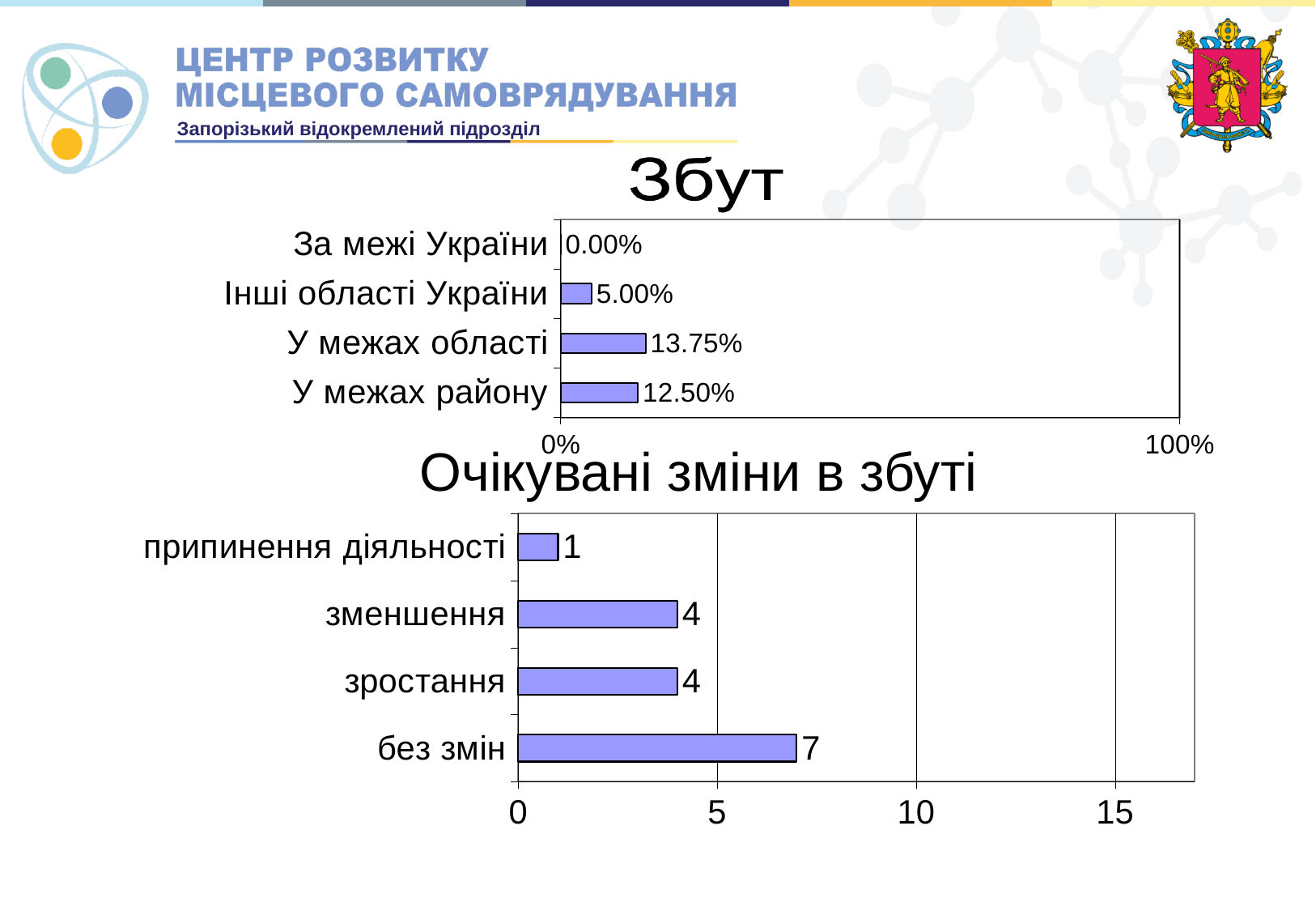
In the chart titled "Очікувані зміни в збуті", what is the difference between the values for "без змін" and "зменшення"? 3 In the chart titled "Очікувані зміни в збуті", what is the value for "припинення діяльності"? 1 In the chart titled "Збут", which category has the lowest value? За межі України In the chart titled "Збут", how many categories are shown? 4 What kind of chart is the chart titled "Очікувані зміни в збуті"? bar chart In the chart titled "Збут", what is the value for "У межах області"? 13.75% In the chart titled "Очікувані зміни в збуті", is the value for "без змін" greater or less than 5? greater In the chart titled "Очікувані зміни в збуті", which category has the highest value? без змін In the chart titled "Збут", what is the difference between the values for "У межах області" and "У межах району"? 1.25% In the chart titled "Збут", which category has the highest value? У межах області In the chart titled "Очікувані зміни в збуті", what is the value for "без змін"? 7 In the chart titled "Збут", what is the value for "Інші області України"? 5.00%